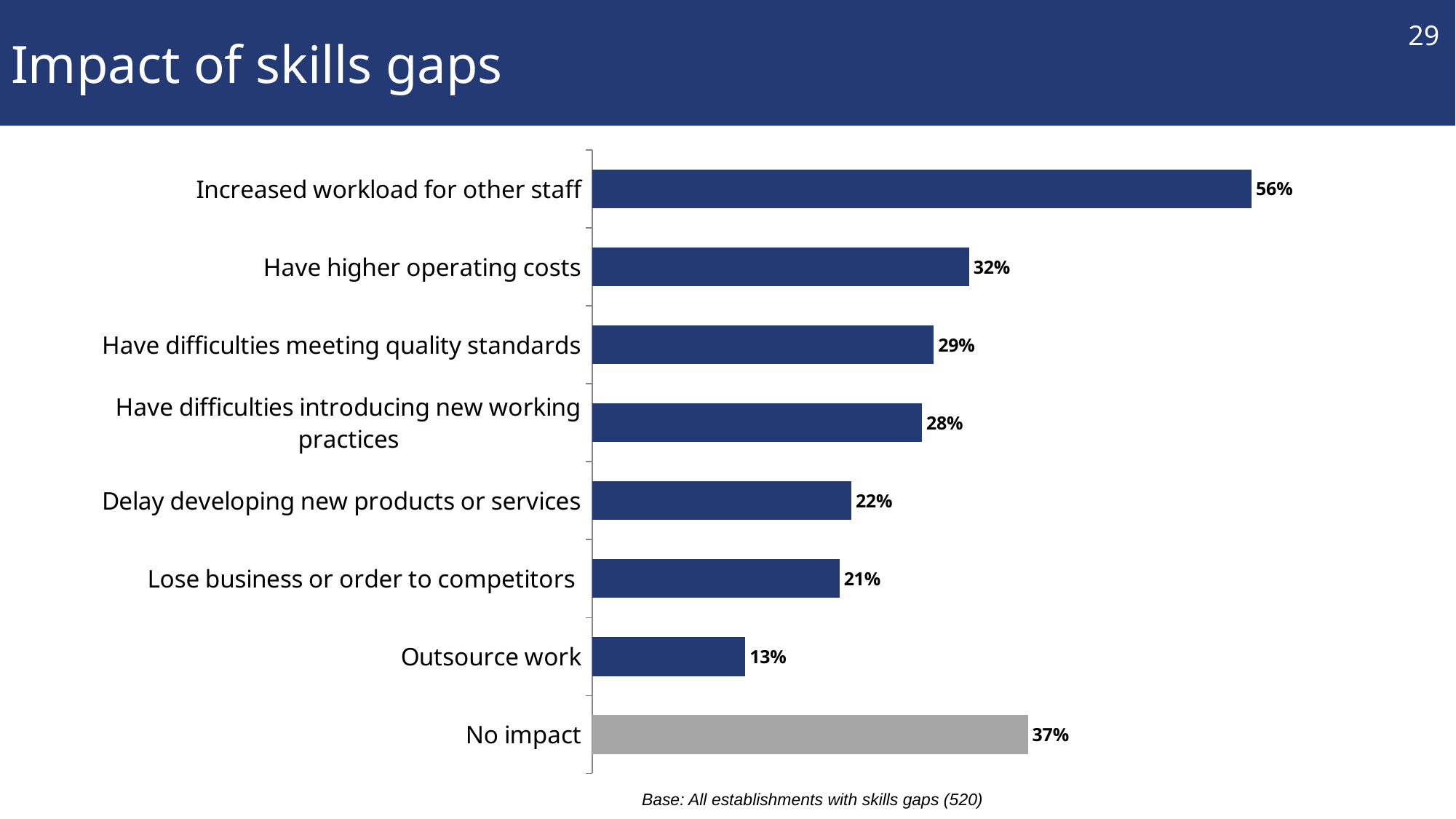
What percentage reported 'No impact'? 37% What is the value for 'Outsource work'? 13% What is the difference between 'Increased workload for other staff' and 'Have higher operating costs'? 24 percentage points What is the value for 'Have difficulties introducing new working practices'? 28% Which bar is coloured grey rather than dark blue? No impact Which category has the lowest value? Outsource work How many categories are shown in the chart? 8 What is the difference between 'No impact' and 'Outsource work'? 24 percentage points What percentage of establishments reported increased workload for other staff? 56% Which is larger: 'Delay developing new products or services' or 'Lose business or order to competitors'? Delay developing new products or services What type of chart is shown on the slide? Bar chart Which category has the highest value? Increased workload for other staff